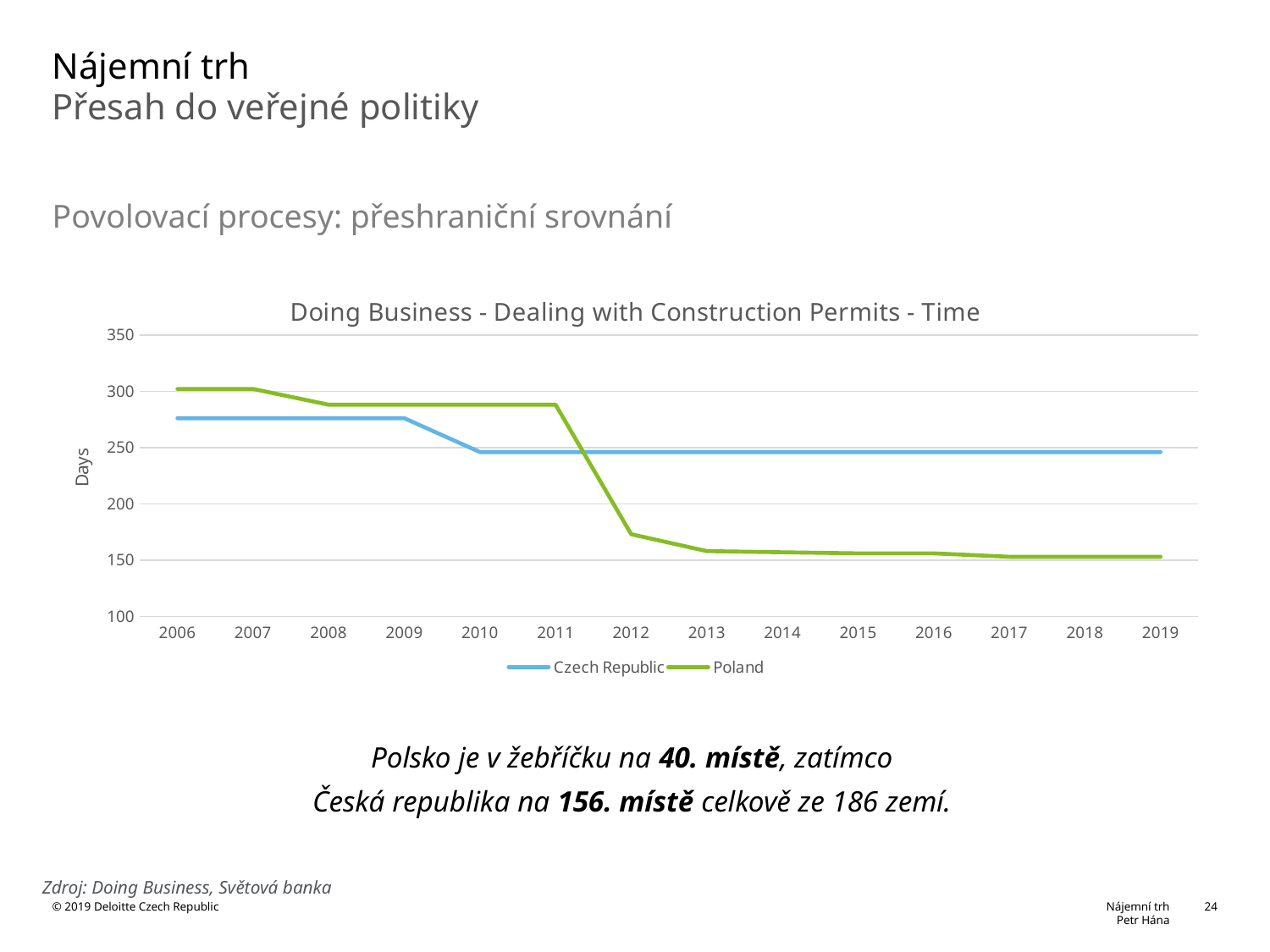
Does the Poland series rise or fall from 2006 to 2019? fall Is the value for Poland in 2008 greater or less than 250? greater What is the title of the chart? Doing Business - Dealing with Construction Permits - Time Is the value for Czech Republic in 2006 greater or less than 250? greater How many series does the chart legend list? 2 In 2012, which series has the lower value, Czech Republic or Poland? Poland Is the value for Poland in 2019 greater or less than 200? less In 2019, which series has the higher value, Czech Republic or Poland? Czech Republic How many years are shown on the x axis of the chart? 14 What is the label of the vertical axis of the chart? Days In 2006, which series has the higher value, Czech Republic or Poland? Poland What kind of chart is shown on the slide? line chart